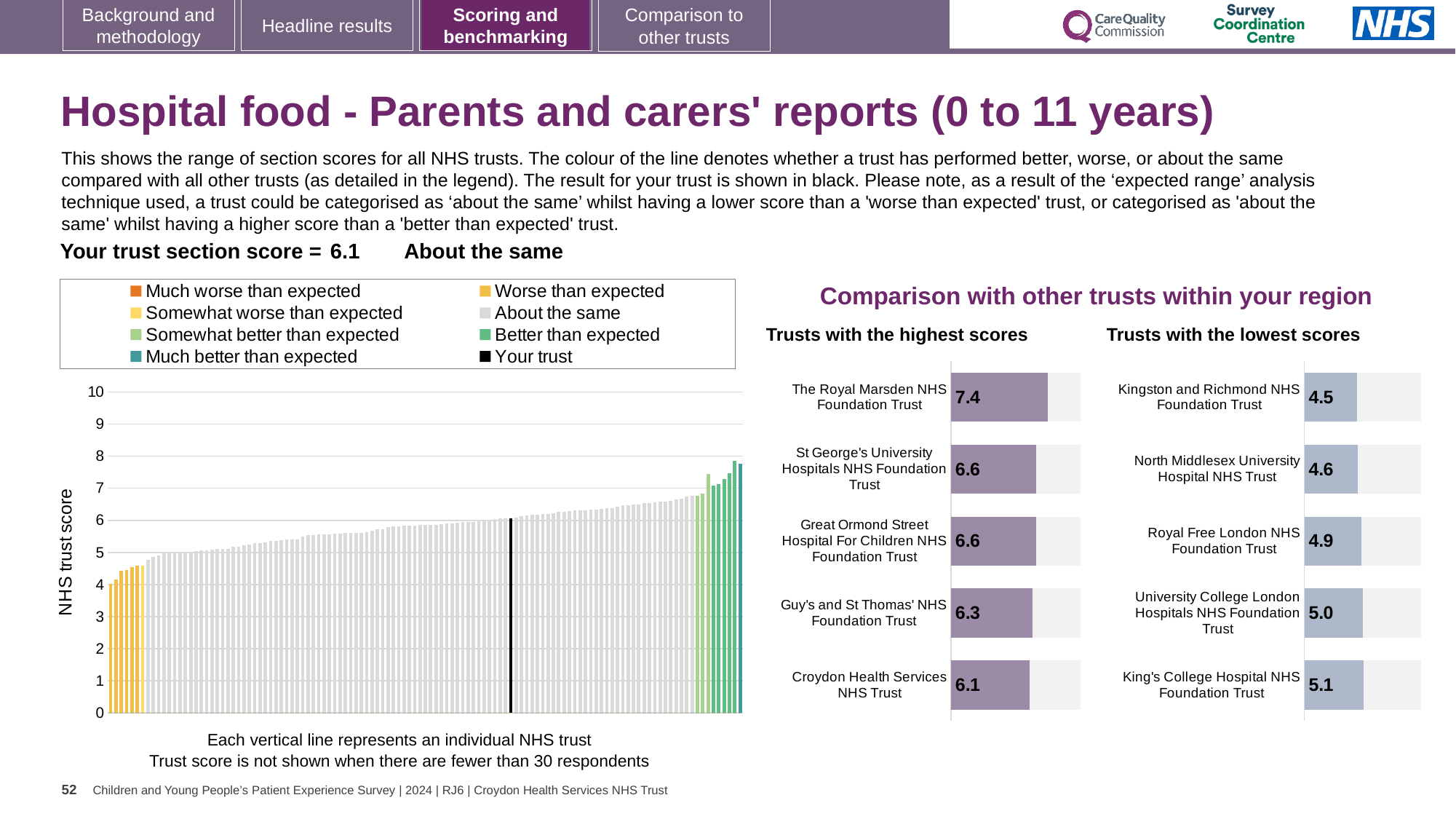
How many trusts are listed in the 'Trusts with the lowest scores' chart? 5 How many entries does the legend of the main NHS trust score chart list? 8 In the 'Trusts with the highest scores' chart, which trust has the highest score? The Royal Marsden NHS Foundation Trust In the 'Trusts with the highest scores' chart, what is the difference between The Royal Marsden NHS Foundation Trust's score and Croydon Health Services NHS Trust's score? 1.3 In the 'Trusts with the lowest scores' chart, what is the difference between King's College Hospital NHS Foundation Trust's score and Kingston and Richmond NHS Foundation Trust's score? 0.6 In the 'Trusts with the highest scores' chart, what is the score for The Royal Marsden NHS Foundation Trust? 7.4 In the 'Trusts with the lowest scores' chart, which has the larger score: North Middlesex University Hospital NHS Trust or University College London Hospitals NHS Foundation Trust? University College London Hospitals NHS Foundation Trust In the main NHS trust score chart on the left, do the bar values rise or fall from left to right? Rise In the 'Trusts with the highest scores' chart, what is the score for Guy's and St Thomas' NHS Foundation Trust? 6.3 What kind of chart is the main chart showing NHS trust scores on the left of the slide? Bar chart In the 'Trusts with the lowest scores' chart, what is the score for Royal Free London NHS Foundation Trust? 4.9 In the 'Trusts with the lowest scores' chart, which trust has the lowest score? Kingston and Richmond NHS Foundation Trust